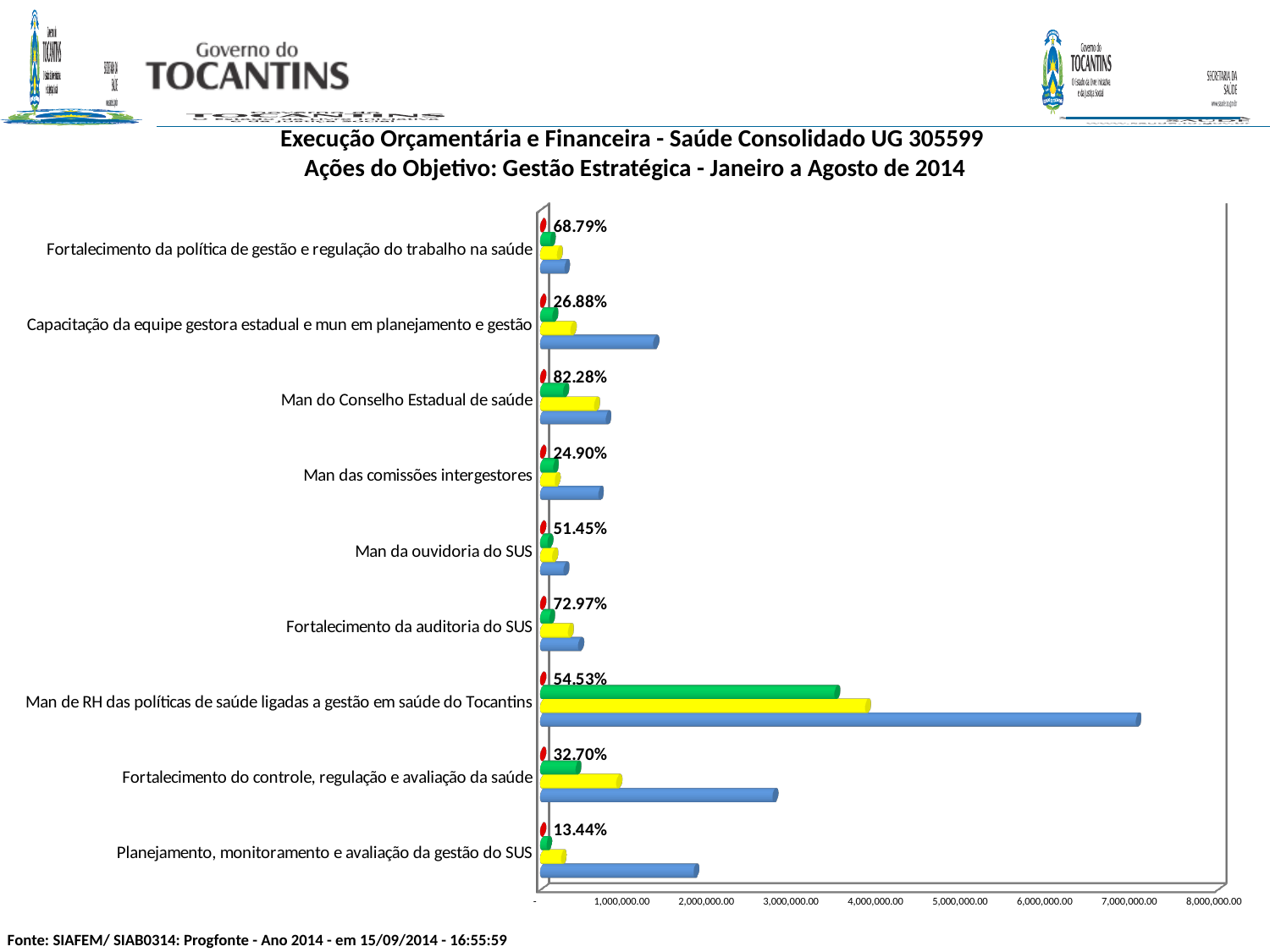
What percentage is shown for Man do Conselho Estadual de saúde? 82.28% Which category has the longest blue bar? Man de RH das políticas de saúde ligadas a gestão em saúde do Tocantins How many categories are shown on the chart? 9 Is the value of the blue bar for Fortalecimento do controle, regulação e avaliação da saúde greater or less than 3,000,000.00? less Is the value of the blue bar for Man de RH das políticas de saúde ligadas a gestão em saúde do Tocantins greater or less than 6,000,000.00? greater What is the difference between the percentage for Man do Conselho Estadual de saúde and the percentage for Planejamento, monitoramento e avaliação da gestão do SUS? 68.84% What percentage is shown for Man de RH das políticas de saúde ligadas a gestão em saúde do Tocantins? 54.53% Which category has the highest percentage label? Man do Conselho Estadual de saúde Which category has the lowest percentage label? Planejamento, monitoramento e avaliação da gestão do SUS Which has a higher percentage label: Fortalecimento da auditoria do SUS or Fortalecimento da política de gestão e regulação do trabalho na saúde? Fortalecimento da auditoria do SUS What kind of chart is shown on the slide? Bar chart What percentage is shown for Planejamento, monitoramento e avaliação da gestão do SUS? 13.44%